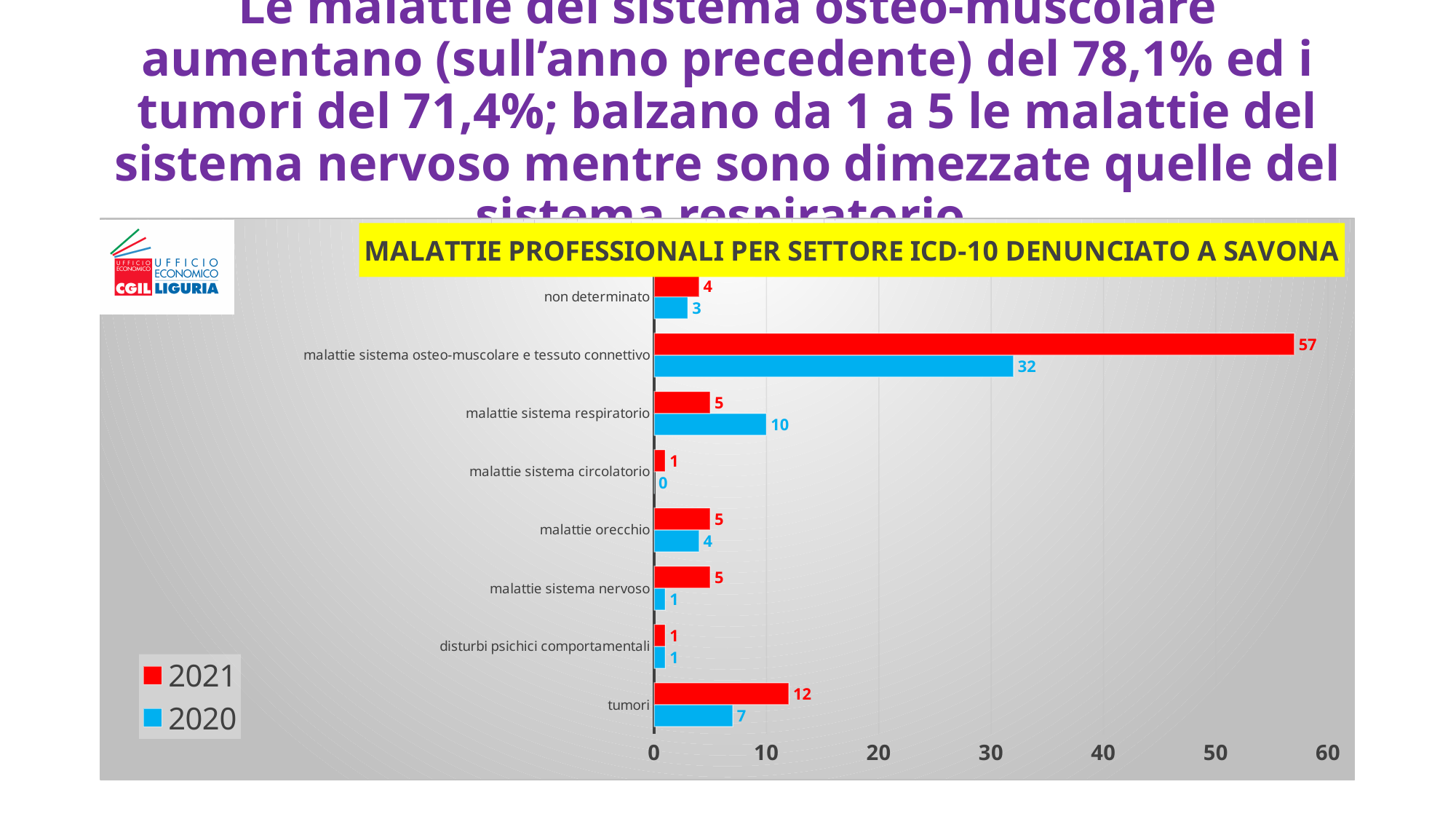
For malattie sistema respiratorio, which year has the larger value, 2021 or 2020? 2020 What is the difference between the 2021 and 2020 values for tumori? 5 What is the difference between the 2021 and 2020 values for malattie sistema osteo-muscolare e tessuto connettivo? 25 What is the 2020 value for tumori? 7 How many series does the legend list? 2 How many categories are shown on the chart? 8 What is the 2021 value for malattie sistema osteo-muscolare e tessuto connettivo? 57 Which category has the lowest 2020 value? malattie sistema circolatorio Is the 2020 value for malattie sistema osteo-muscolare e tessuto connettivo greater or less than 40? less What is the 2020 value for malattie sistema respiratorio? 10 What kind of chart is shown on the slide? bar chart Which category has the highest 2021 value? malattie sistema osteo-muscolare e tessuto connettivo